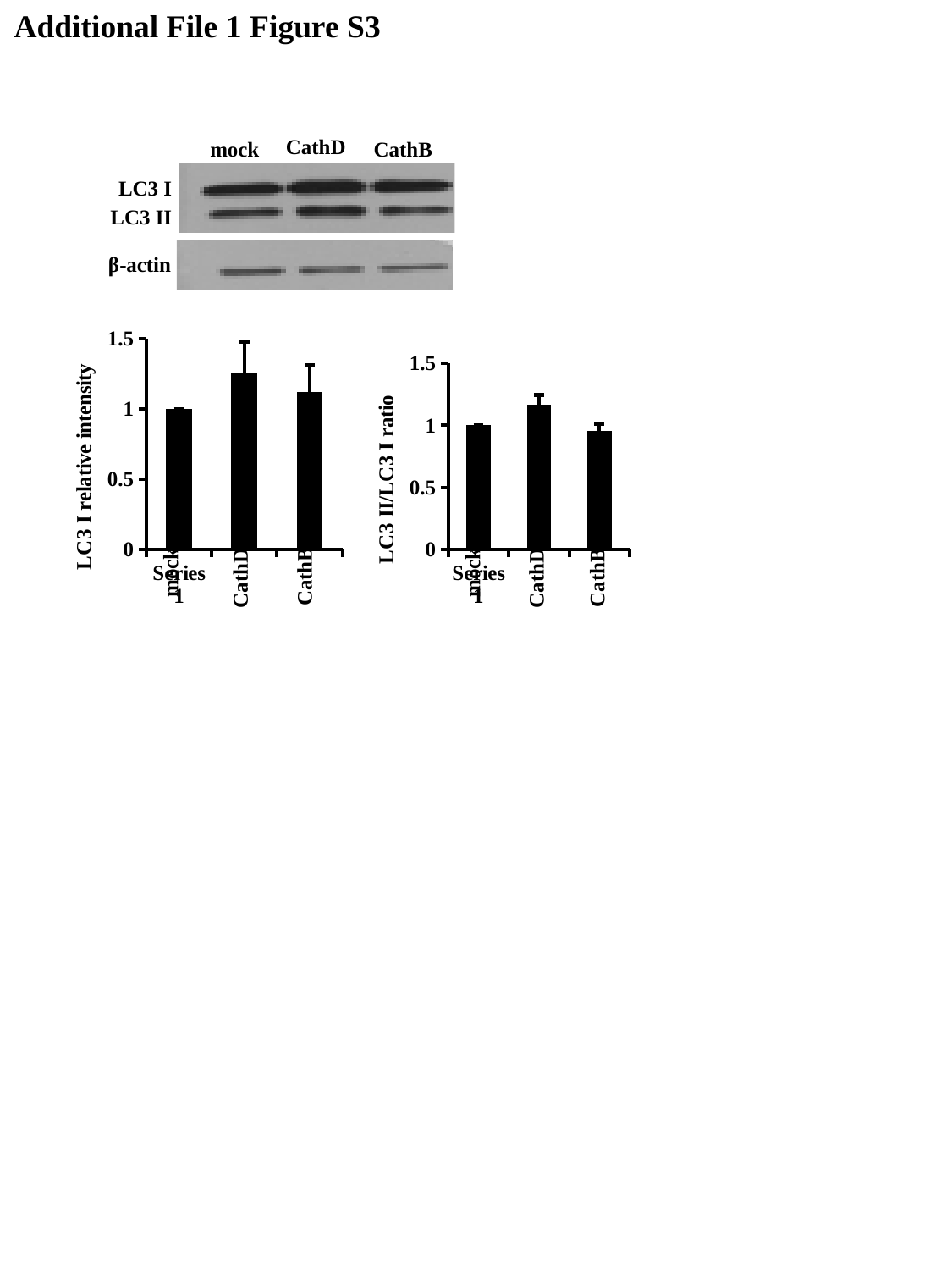
In the right chart (LC3 II/LC3 I ratio), which is larger, the value for CathD or the value for mock? CathD What type of chart is the left chart labelled 'LC3 I relative intensity'? bar chart In the right chart (LC3 II/LC3 I ratio), what is the value for mock? 1 In the left chart (LC3 I relative intensity), what is the value for mock? 1 In the left chart (LC3 I relative intensity), how many categories are shown on the x axis? 3 What is the y-axis title of the right chart? LC3 II/LC3 I ratio In the right chart (LC3 II/LC3 I ratio), is the value for CathD greater or less than 1? greater In the right chart (LC3 II/LC3 I ratio), which category has the highest bar? CathD In the left chart (LC3 I relative intensity), which category has the highest bar? CathD In the left chart (LC3 I relative intensity), is the value for CathD greater or less than 1? greater In the left chart (LC3 I relative intensity), which category has the lowest bar? mock In the right chart (LC3 II/LC3 I ratio), how many bars are plotted? 3